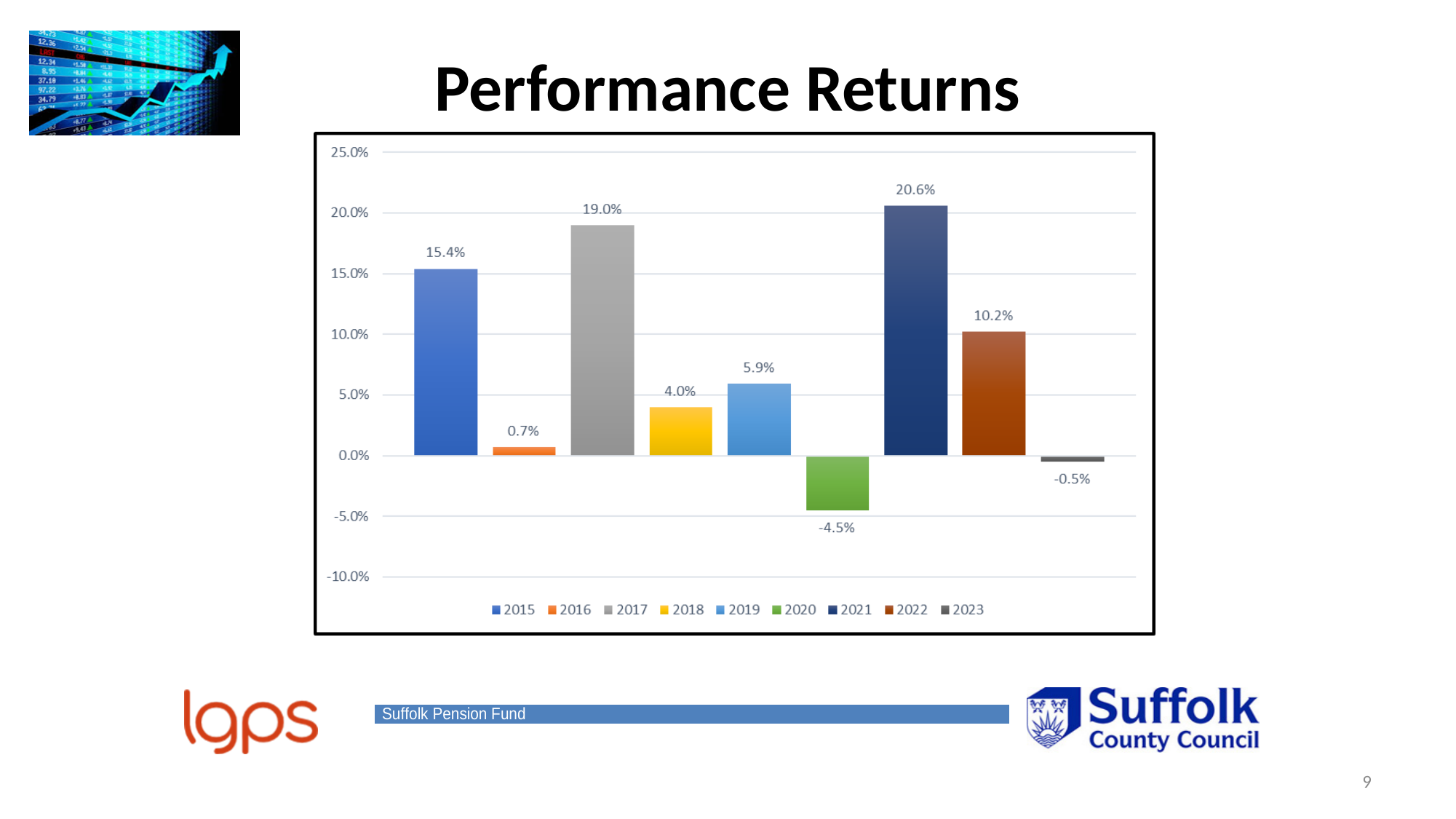
Which year has the lowest performance return? 2020 What is the difference between the returns for 2021 and 2022? 10.4% What is the performance return shown for 2017? 19.0% How many years show a negative return? 2 How many entries does the legend list? 9 What is the performance return shown for 2020? -4.5% Is the value for 2018 greater or less than 5.0%? less Which year has the highest performance return? 2021 Which year has the larger return, 2015 or 2019? 2015 What kind of chart is shown on the slide? bar chart How many years are shown in the chart? 9 What is the performance return shown for 2023? -0.5%